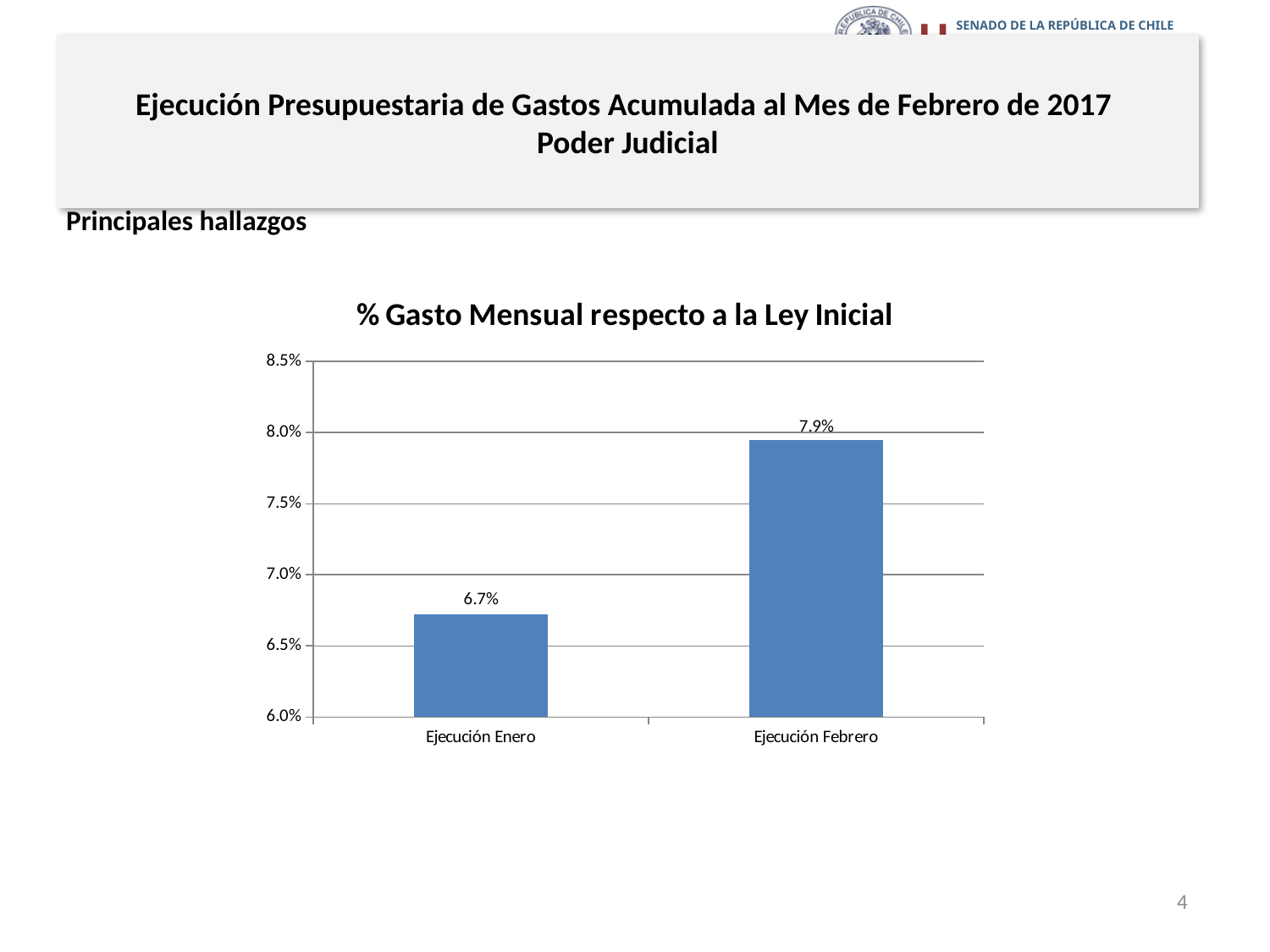
Is the value for Ejecución Enero greater or less than 7.0%? less Which category has the lowest value? Ejecución Enero What is the difference between the values for Ejecución Febrero and Ejecución Enero? 1.2% Is the value for Ejecución Febrero greater or less than 7.5%? greater How many categories are shown on the chart? 2 What kind of chart is shown on the slide? bar chart Which category has the highest value? Ejecución Febrero What is the title of the chart? % Gasto Mensual respecto a la Ley Inicial What is the value for Ejecución Febrero? 7.9% What is the value for Ejecución Enero? 6.7% Do the values rise or fall from Ejecución Enero to Ejecución Febrero? rise Which is larger, the value for Ejecución Enero or Ejecución Febrero? Ejecución Febrero